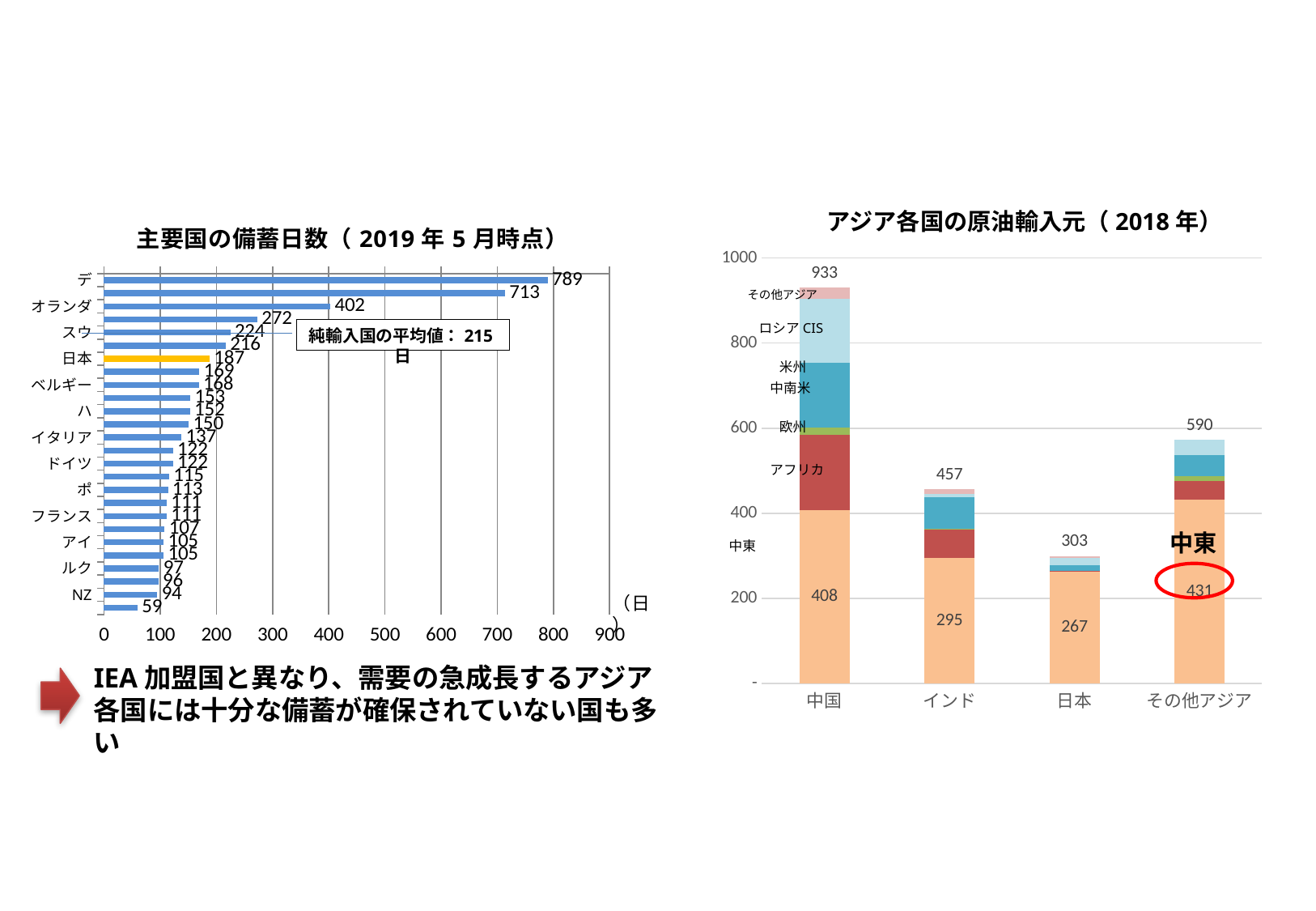
In the right chart アジア各国の原油輸入元（2018年）, what is the 中東 value for その他アジア? 431 In the left chart 主要国の備蓄日数, which country has the highest value? デ What kind of chart is the left chart titled 主要国の備蓄日数（2019年5月時点）? bar chart In the right chart アジア各国の原油輸入元（2018年）, what is the difference between the 中東 values for 中国 and インド? 113 In the left chart 主要国の備蓄日数, what is the value for オランダ? 402 In the right chart アジア各国の原油輸入元（2018年）, what is the total for 中国? 933 How many categories are shown on the x axis of the right chart アジア各国の原油輸入元（2018年）? 4 In the right chart アジア各国の原油輸入元（2018年）, which has the larger 中東 value, インド or 日本? インド In the left chart 主要国の備蓄日数, what is the value for 日本? 187 In the left chart 主要国の備蓄日数, what average value for net importing countries (純輸入国の平均値) is shown in the annotation box? 215日 In the right chart アジア各国の原油輸入元（2018年）, which category has the lowest total? 日本 In the left chart 主要国の備蓄日数, what is the difference between the values for オランダ and 日本? 215